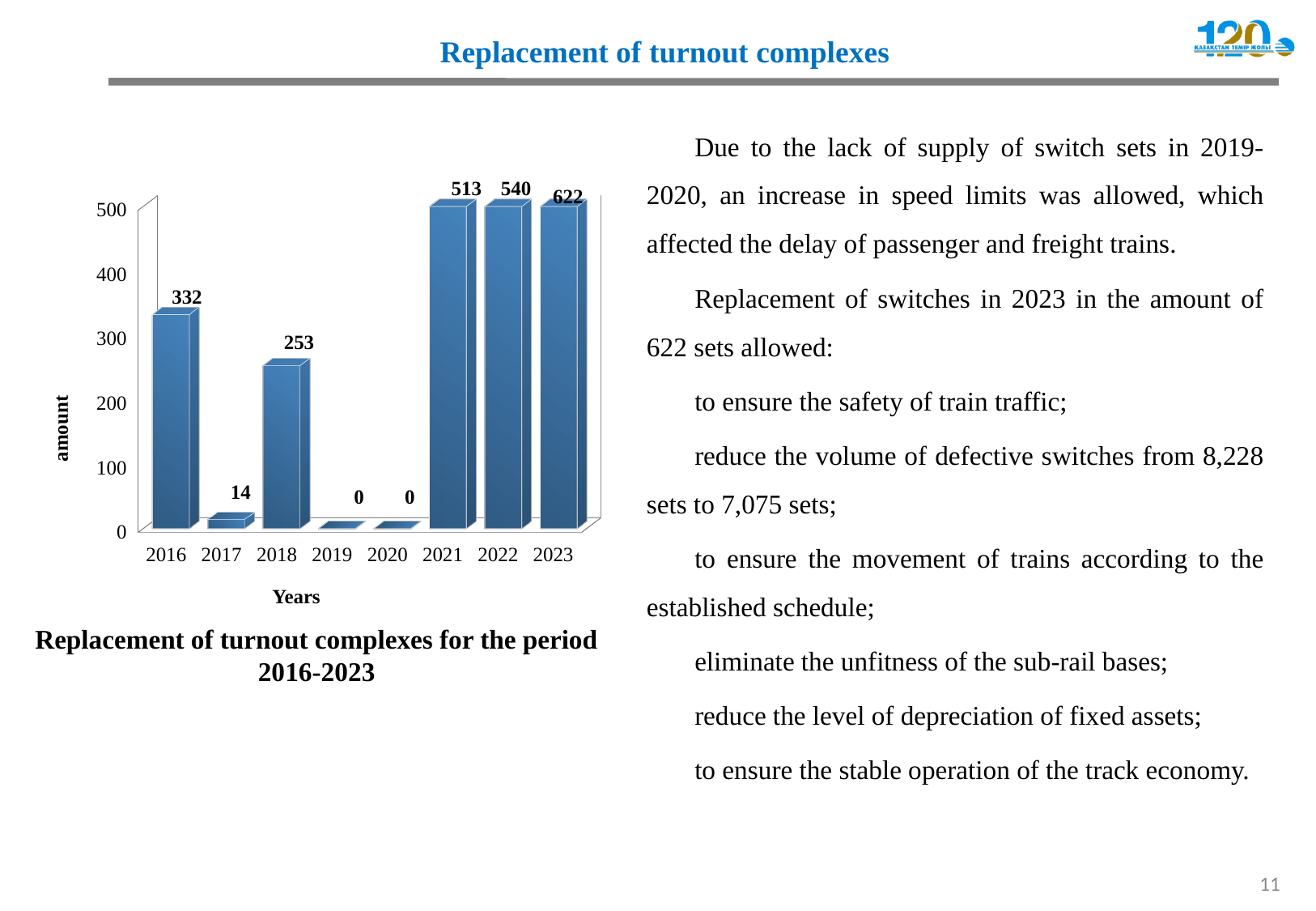
Which years have a value of 0? 2019 and 2020 What is the difference between the values for 2023 and 2021? 109 What is the value for 2022? 540 Is the value for 2017 greater or less than 100? less Do the values rise or fall from 2020 to 2023? rise What kind of chart is this? bar chart Which is larger, the value for 2016 or the value for 2018? 2016 What is the value for 2018? 253 What is the value for 2016? 332 Which year has the highest value? 2023 What is the label of the y axis? amount How many years are shown on the x axis? 8